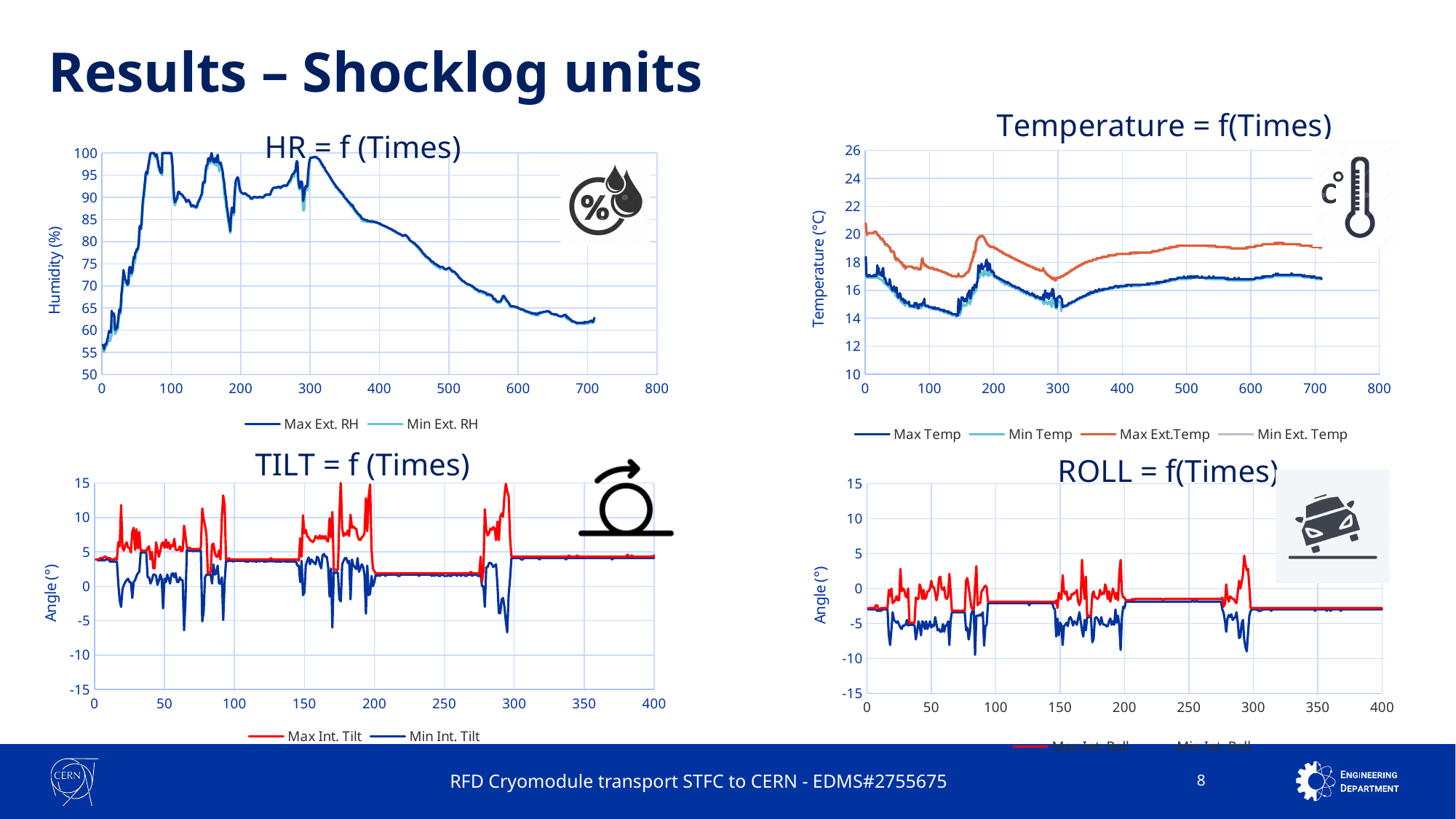
In the 'HR = f (Times)' chart, is the Max Ext. RH value at time 300 greater or less than 90? greater In the 'Temperature = f(Times)' chart, at time 500, which series is higher: Max Ext.Temp or Max Temp? Max Ext.Temp In the 'TILT = f (Times)' chart, is the Max Int. Tilt value at time 350 greater or less than 10? less In the 'HR = f (Times)' chart, is the Max Ext. RH value at time 700 greater or less than 70? less What is the y-axis label of the 'ROLL = f(Times)' chart? Angle (°) What kind of chart is the 'HR = f (Times)' chart? line chart How many series does the legend of the 'TILT = f (Times)' chart list? 2 How many series does the legend of the 'HR = f (Times)' chart list? 2 In the 'HR = f (Times)' chart, does the humidity rise or fall between time 300 and time 700? fall How many series does the legend of the 'Temperature = f(Times)' chart list? 4